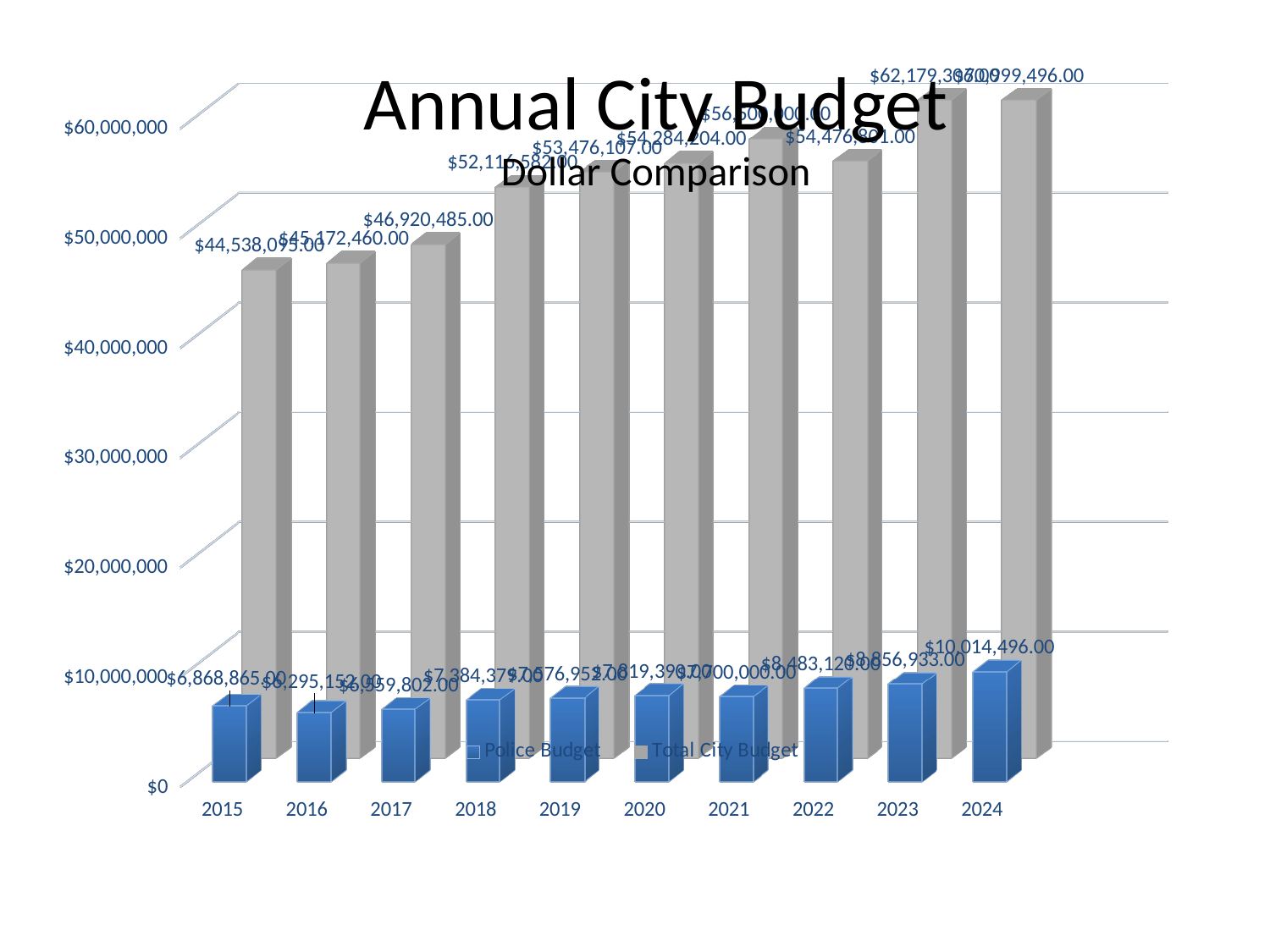
What is the Police Budget value for 2024? $10,014,496.00 What is the difference between the Total City Budget for 2017 and for 2016? $1,748,025.00 What is the Total City Budget value for 2019? $53,476,107.00 Which year has the highest Police Budget? 2024 What kind of chart is shown on the slide? bar chart How many series does the legend list? 2 How many years are shown on the x axis? 10 Is the Total City Budget for 2015 greater or less than $40,000,000? greater What is the Total City Budget value for 2017? $46,920,485.00 Which year has the lowest Total City Budget? 2015 What is the Police Budget value for 2015? $6,868,865.00 Which is larger, the Total City Budget for 2020 or for 2019? 2020